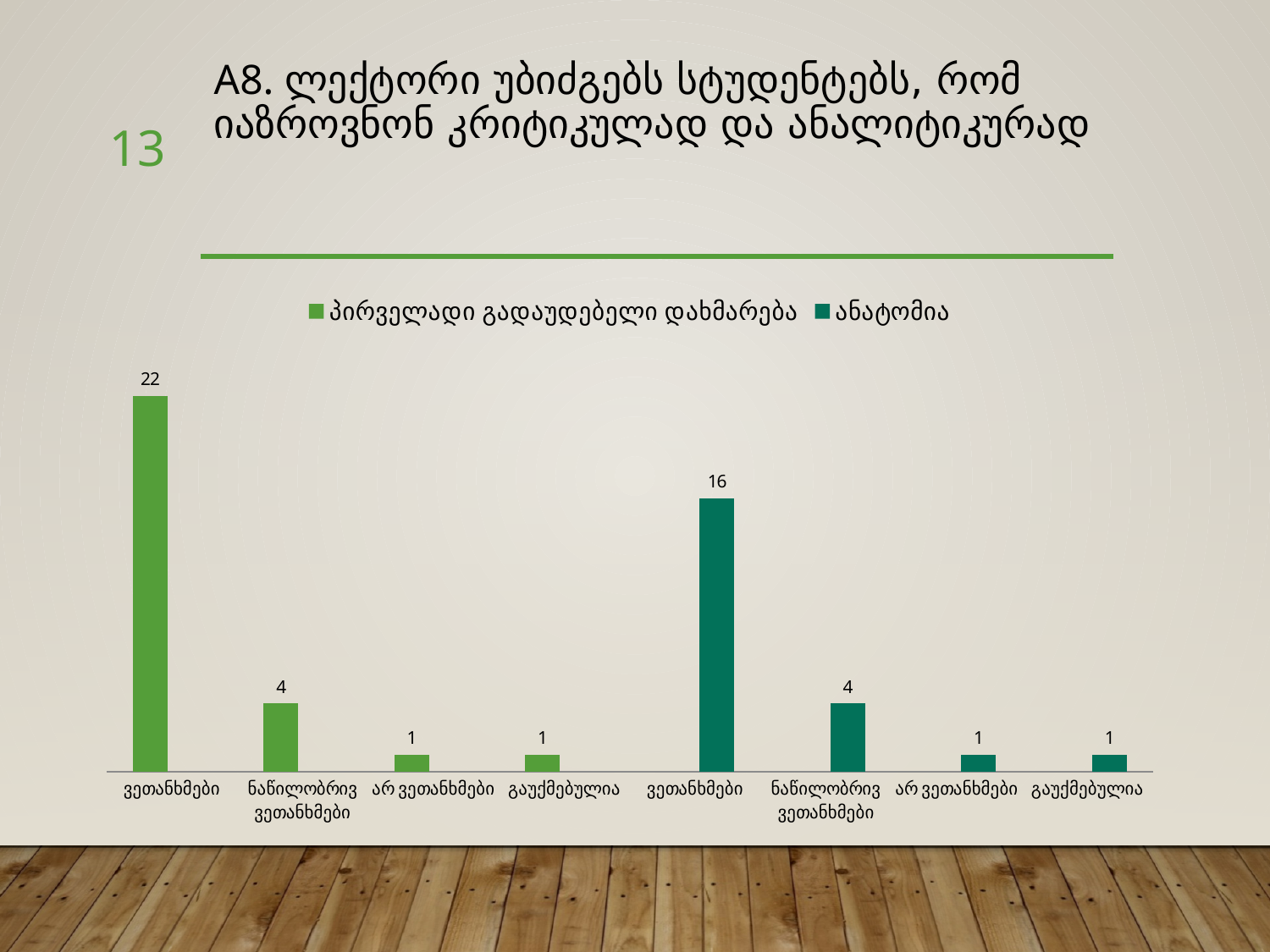
Which category has the highest value in the პირველადი გადაუდებელი დახმარება series? ვეთანხმები What is the value for ვეთანხმები in the ანატომია series? 16 How many series does the legend list? 2 How many bars are plotted in the chart? 8 Which category has the highest value in the ანატომია series? ვეთანხმები What is the value for ვეთანხმები in the პირველადი გადაუდებელი დახმარება series? 22 What is the difference between ვეთანხმები and ნაწილობრივ ვეთანხმები in the ანატომია series? 12 Which is larger: ვეთანხმები for პირველადი გადაუდებელი დახმარება or ვეთანხმები for ანატომია? პირველადი გადაუდებელი დახმარება What kind of chart is shown on the slide? Bar chart What is the difference between the ვეთანხმები values of the პირველადი გადაუდებელი დახმარება and ანატომია series? 6 What is the value for ნაწილობრივ ვეთანხმები in the ანატომია series? 4 What is the value for გაუქმებულია in the პირველადი გადაუდებელი დახმარება series? 1